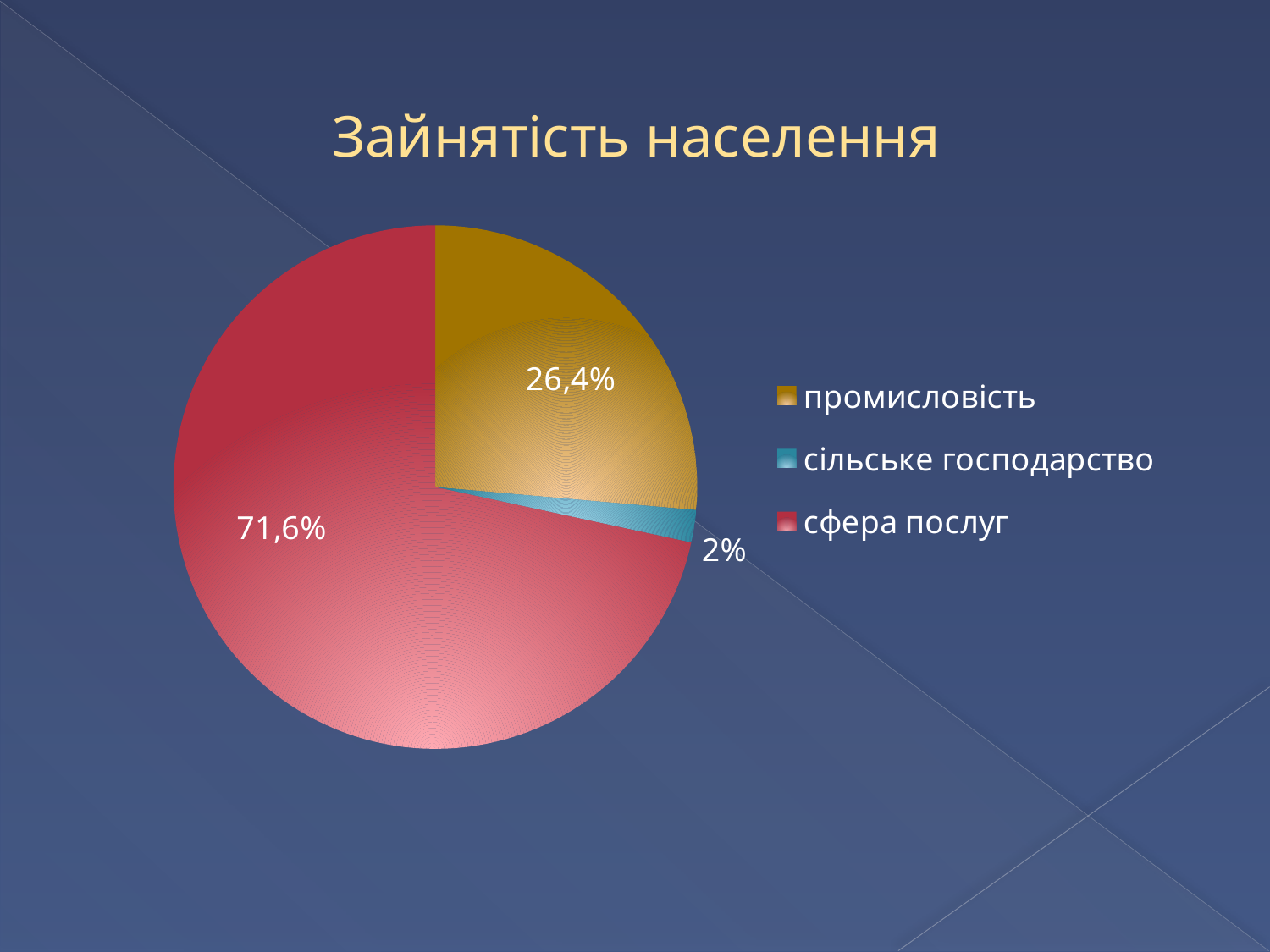
What share of the pie does сфера послуг have? 71,6% How many categories does the pie chart show? 3 How many entries does the legend list? 3 What colour is the slice for сфера послуг? red Which is larger, the share for промисловість or the share for сільське господарство? промисловість What is the difference between the share for сфера послуг and the share for промисловість? 45,2% Which category has the smallest slice of the pie? сільське господарство What share of the pie does промисловість have? 26,4% What kind of chart is shown on the slide? pie chart What share of the pie does сільське господарство have? 2% Which category has the largest slice of the pie? сфера послуг What is the title of the chart? Зайнятість населення